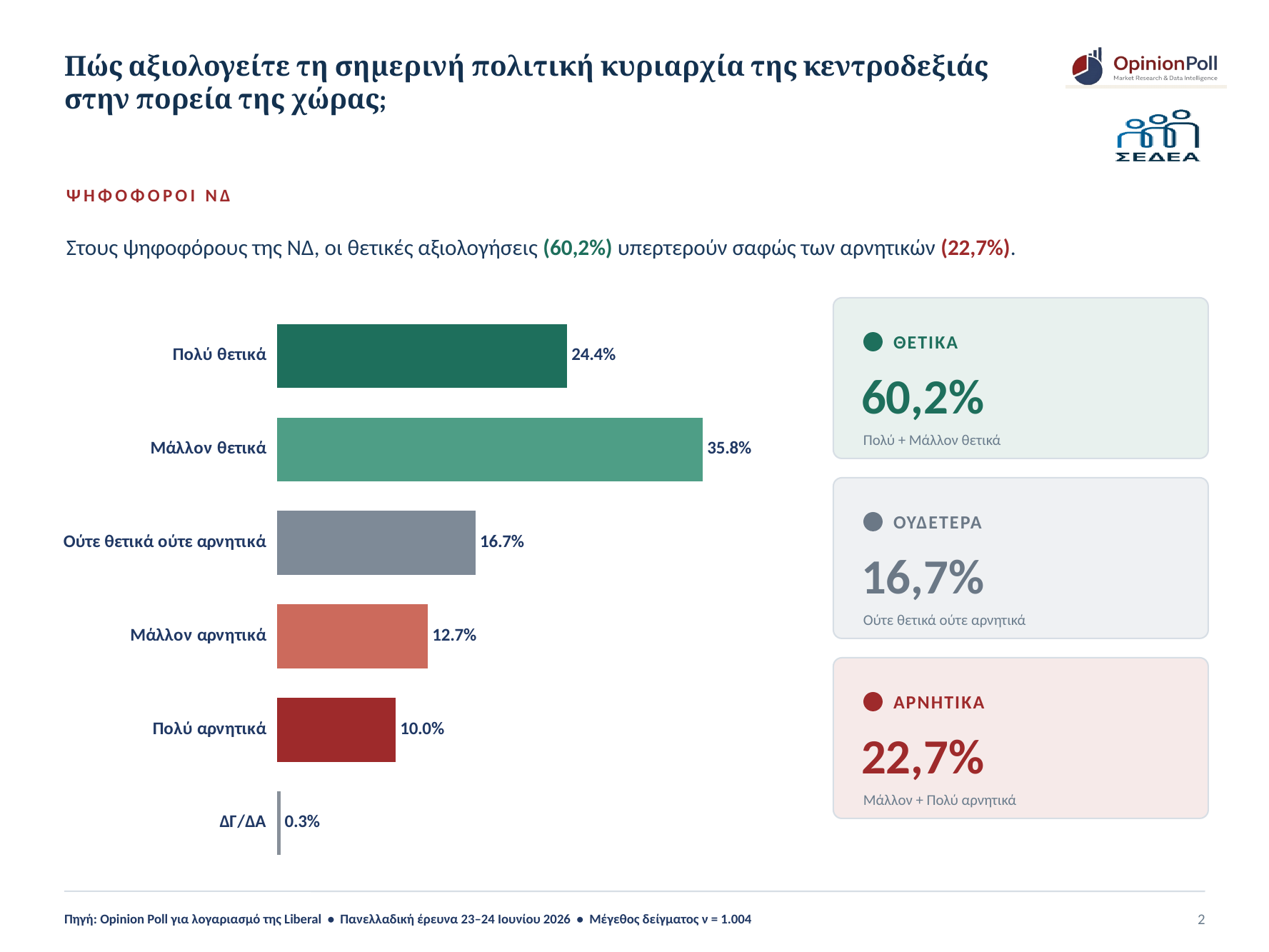
How many categories are shown in the bar chart? 6 What colour is the bar for Πολύ αρνητικά? Dark red What is the difference between Μάλλον θετικά and Πολύ θετικά? 11.4% Which category has the lowest value? ΔΓ/ΔΑ What is the value for ΔΓ/ΔΑ? 0.3% What is the combined value of Πολύ θετικά and Μάλλον θετικά? 60.2% What kind of chart is shown on the slide? Bar chart What is the combined value of Μάλλον αρνητικά and Πολύ αρνητικά? 22.7% Which category has the highest value? Μάλλον θετικά Which is larger, Ούτε θετικά ούτε αρνητικά or Μάλλον αρνητικά? Ούτε θετικά ούτε αρνητικά What is the value for Μάλλον θετικά? 35.8% What is the value for Πολύ αρνητικά? 10.0%